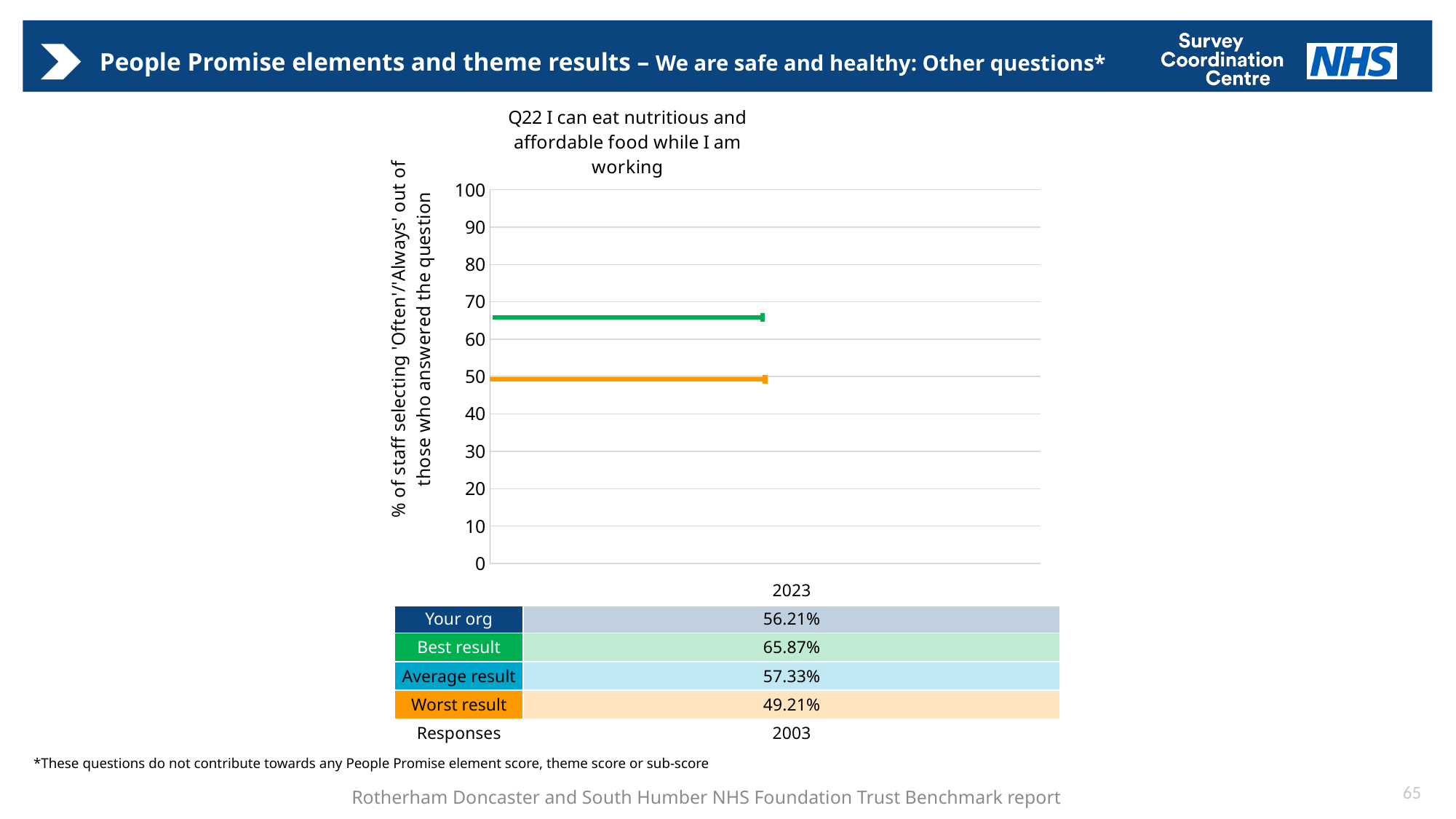
Which result has the highest value in 2023? Best result What is the difference between the Best result and the Worst result in 2023? 16.66% Which result has the lowest value in 2023? Worst result What is the Average result value for 2023? 57.33% How many responses are shown for 2023? 2003 What is the Best result value for 2023? 65.87% Which year is shown on the x axis of the chart? 2023 What is the value for Your org in 2023? 56.21% What is the Worst result value for 2023? 49.21% Is the green line on the chart greater or less than 60? greater What is the title of the chart? Q22 I can eat nutritious and affordable food while I am working Which is larger, Your org or the Average result in 2023? Average result